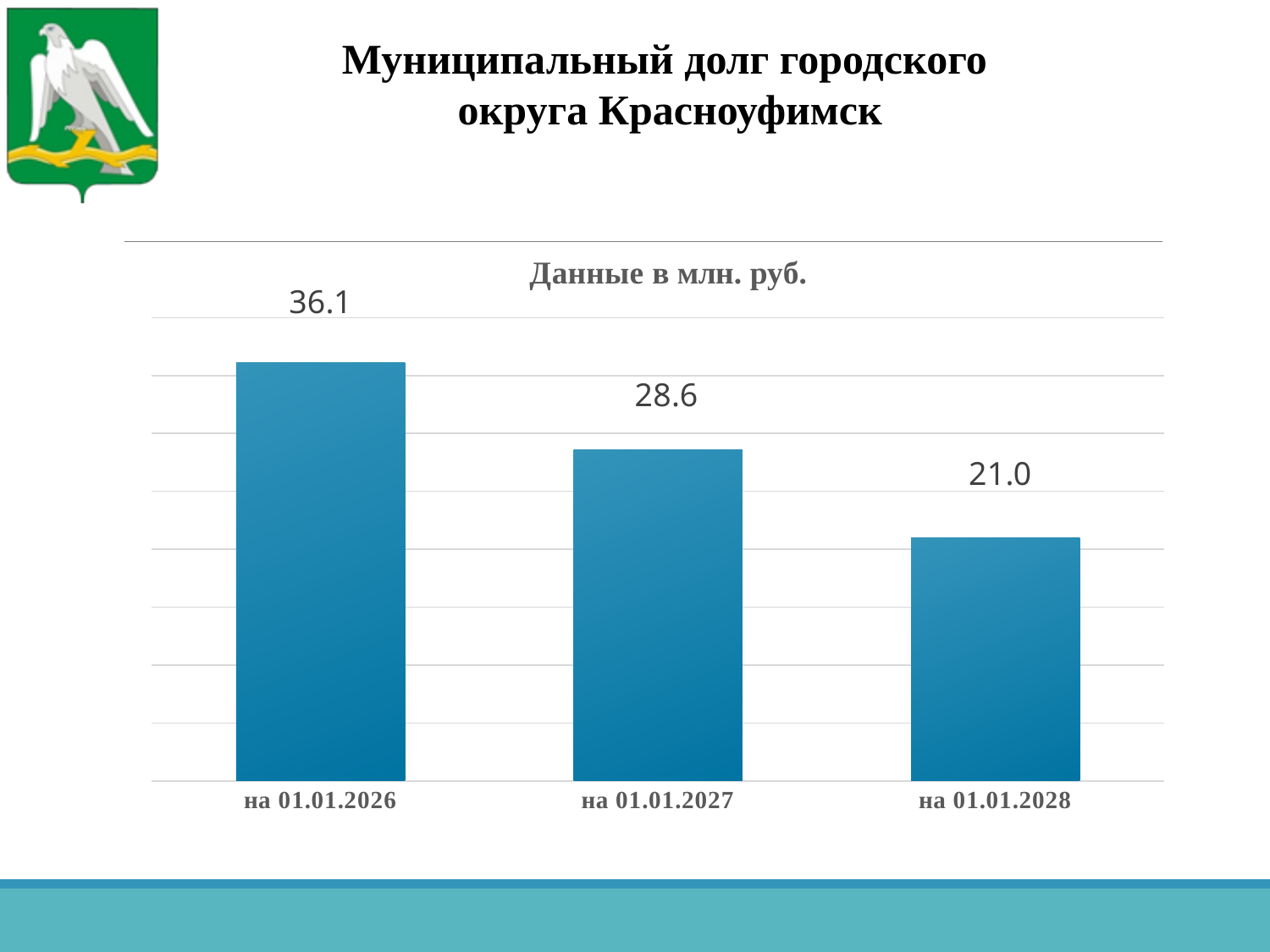
How many dates (categories) are shown on the chart? 3 What is the difference between the values for на 01.01.2026 and на 01.01.2027? 7.5 Which date has the highest municipal debt value? на 01.01.2026 What is the municipal debt value shown for на 01.01.2026? 36.1 What is the municipal debt value shown for на 01.01.2027? 28.6 What is the difference between the values for на 01.01.2027 and на 01.01.2028? 7.6 Which date has the lowest municipal debt value? на 01.01.2028 What is the municipal debt value shown for на 01.01.2028? 21.0 What kind of chart is shown on the slide? bar chart Which is larger, the value for на 01.01.2026 or the value for на 01.01.2028? на 01.01.2026 In what units are the data on the chart given, according to the chart's subtitle? млн. руб. Do the values rise or fall from на 01.01.2026 to на 01.01.2028? fall